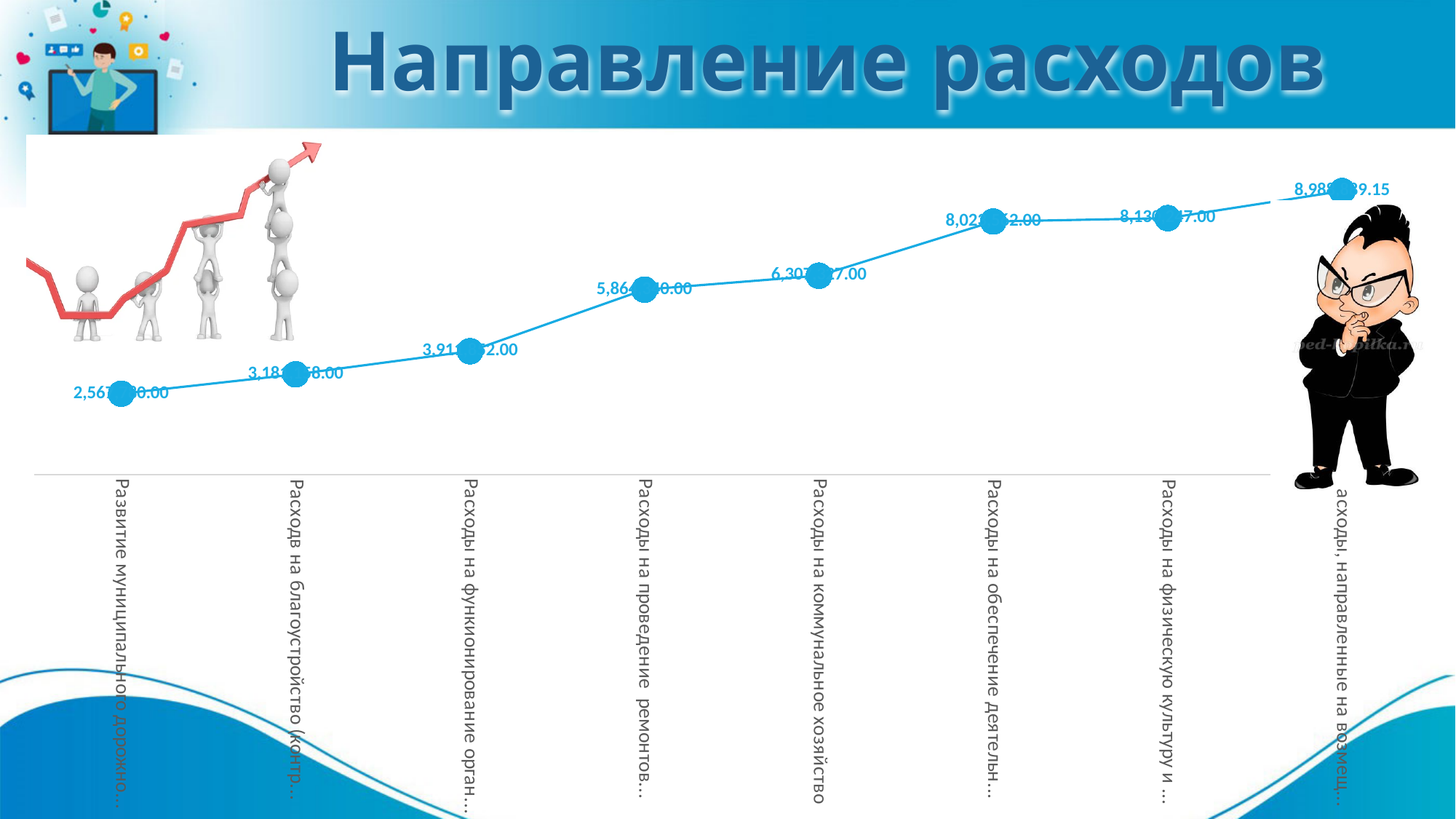
Which is larger: the value for 'Расходы на коммунальное хозяйство' or the value for 'Расходы на проведение ремонтов...'? Расходы на коммунальное хозяйство How many data points are plotted on the line chart? 8 What colour is the plotted line and its markers? blue Which is larger: the value for 'Расходы на благоустройство' or the value for 'Расходы на функционирование орган...'? Расходы на функционирование орган... Which category has the lowest value on the chart? Развитие муниципального дорожно... What is the title of the slide's chart? Направление расходов What kind of chart is shown on the slide? line chart Do the values rise or fall from left to right along the x axis? rise Which is larger: the value for 'Развитие муниципального дорожно...' or the value for 'Расходы на физическую культуру и ...'? Расходы на физическую культуру и ... Which category has the highest value on the chart? Расходы, направленные на возмещ...